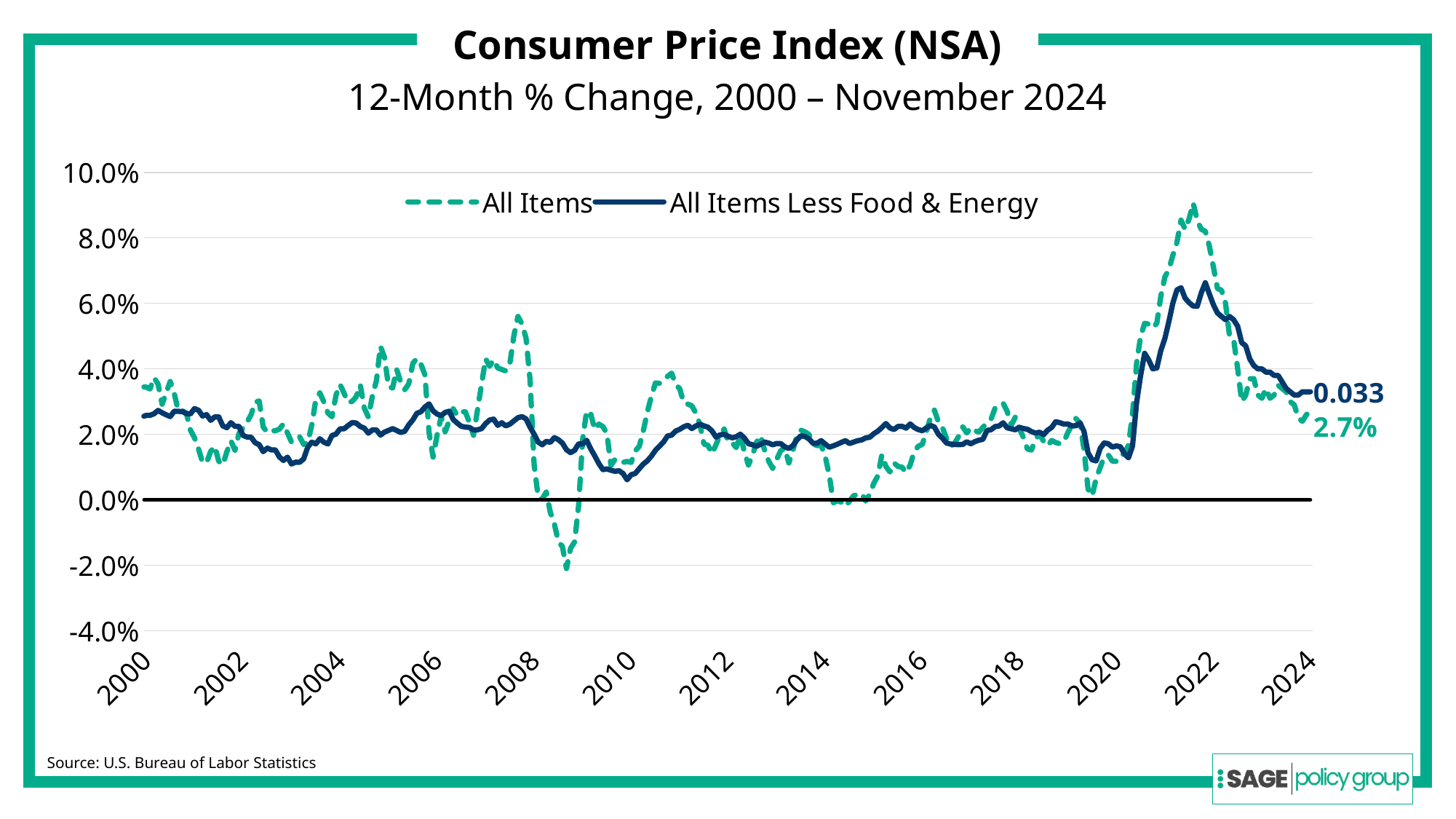
How many series does the legend list? 2 Which series reaches the higher peak around 2022? All Items Is the peak value of the All Items line around 2022 greater or less than 8.0%? greater What kind of chart is shown on the slide? line chart Is the peak value of the All Items Less Food & Energy line around 2022 greater or less than 6.0%? greater What is the title of the chart? Consumer Price Index (NSA) At the end of the chart in 2024, which series is higher: All Items or All Items Less Food & Energy? All Items Less Food & Energy What is the data label shown at the end of the All Items Less Food & Energy line (November 2024)? 0.033 Is the lowest value of the All Items line around 2009 greater or less than 0.0%? less What source is cited for the chart data? U.S. Bureau of Labor Statistics What is the data label shown at the end of the All Items line (November 2024)? 2.7% Does the All Items line rise or fall from its 2022 peak to 2024? fall